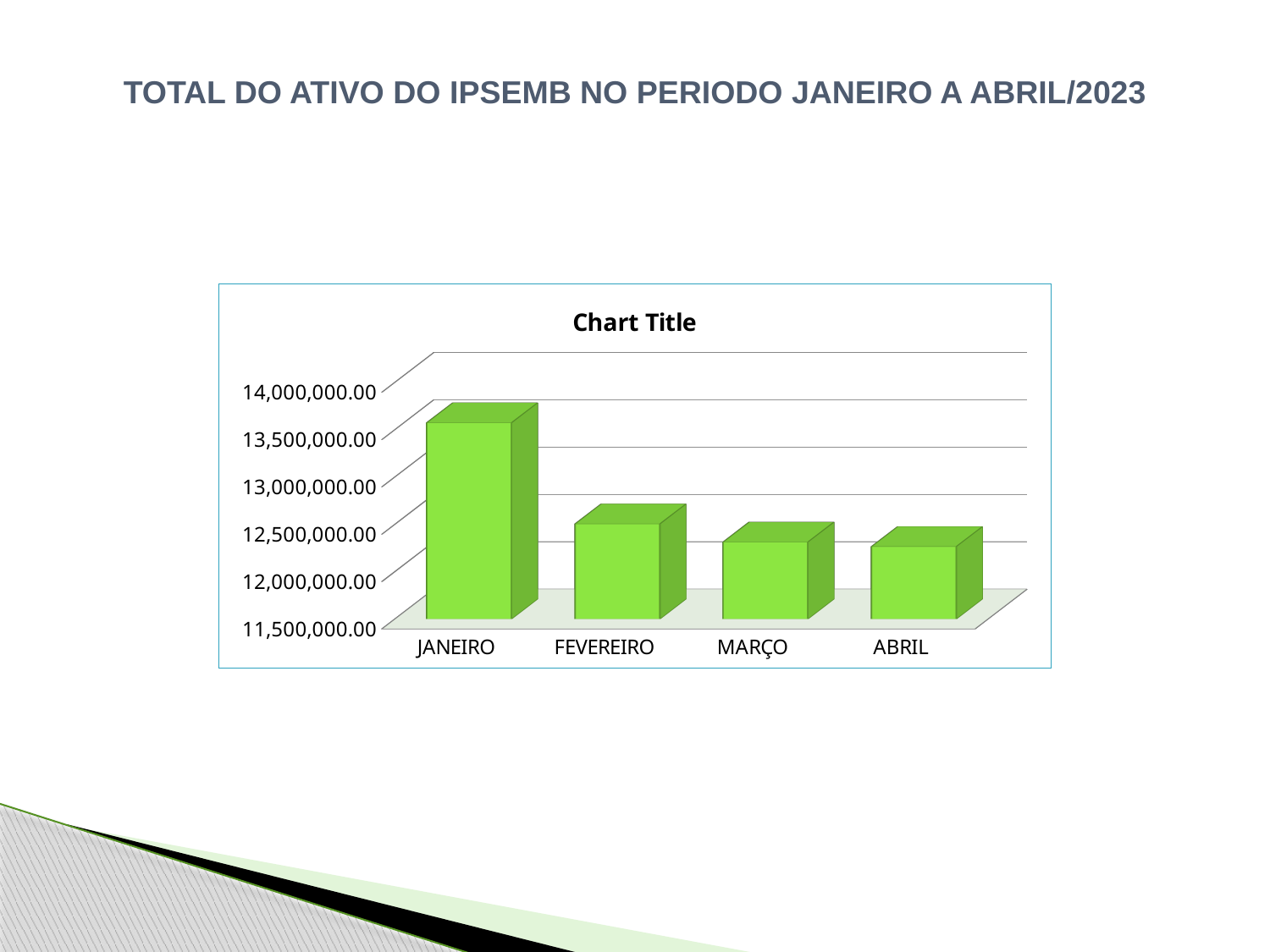
Which month has the highest value on the chart? JANEIRO Do the values generally rise or fall from JANEIRO to ABRIL? fall Which is larger, the value for JANEIRO or the value for FEVEREIRO? JANEIRO What colour are the bars in the chart? green Is the value for ABRIL greater or less than 12,000,000.00? greater Is the value for MARÇO greater or less than 13,000,000.00? less What kind of chart is shown on the slide? bar chart Is the value for ABRIL greater or less than 13,000,000.00? less What is the title shown inside the chart area? Chart Title How many categories (months) are plotted on the chart? 4 Which is larger, the value for FEVEREIRO or the value for ABRIL? FEVEREIRO